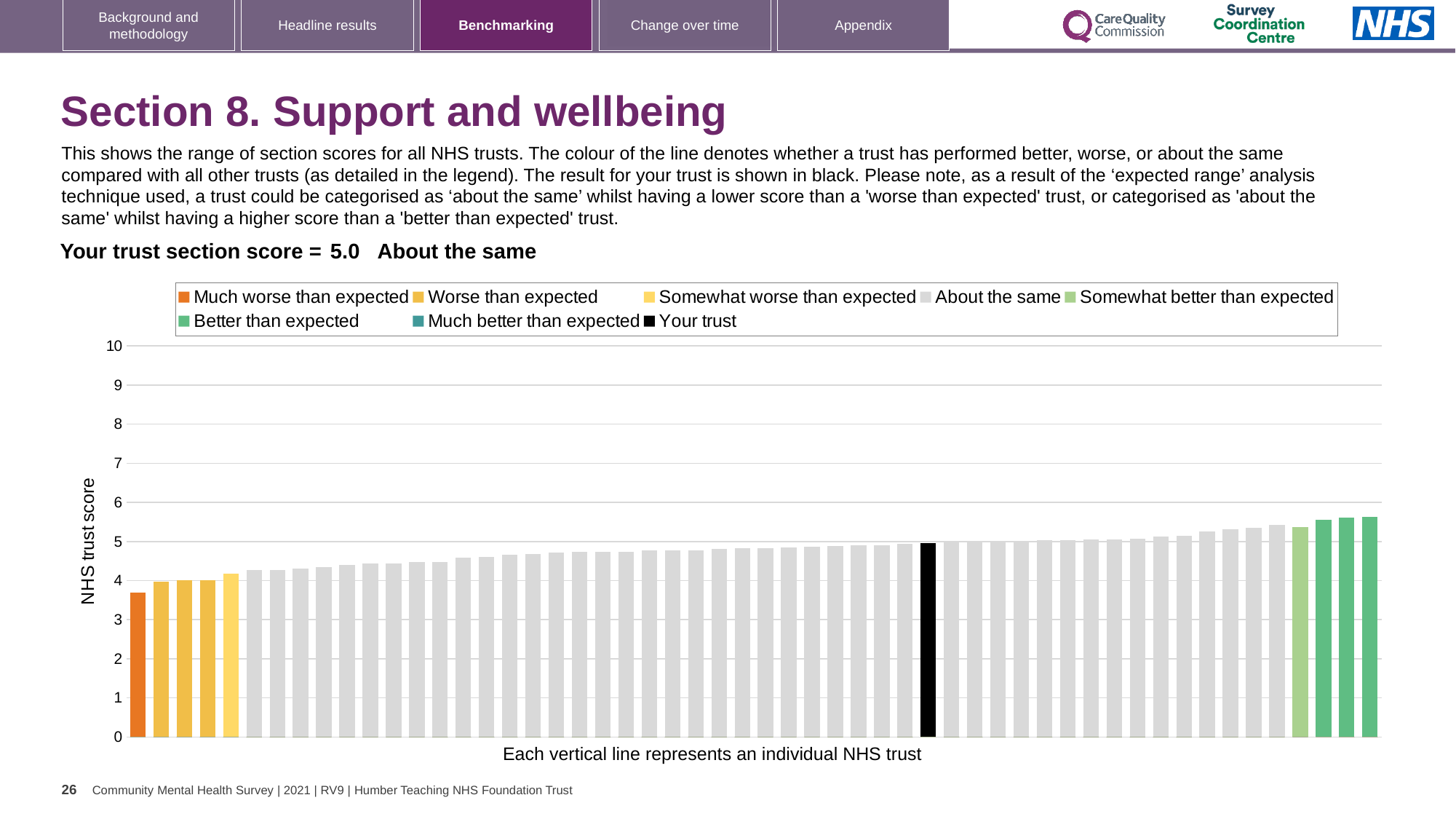
Which legend category does the lowest bar belong to? Much worse than expected Which legend category do the highest bars belong to? Better than expected How many entries does the chart legend list? 8 What kind of chart is shown on the slide? bar chart Is the value of the highest bar greater or less than 6? less What is the label on the vertical axis of the chart? NHS trust score Do the bar values rise or fall from left to right along the x axis? rise What is the section score for your trust shown on the slide? 5.0 Is the value of the lowest bar (the orange one) greater or less than 4? less Which benchmarking category is your trust placed in for Section 8? About the same How many bars are coloured as 'Much worse than expected'? 1 Is the value of the black 'Your trust' bar greater or less than 4? greater